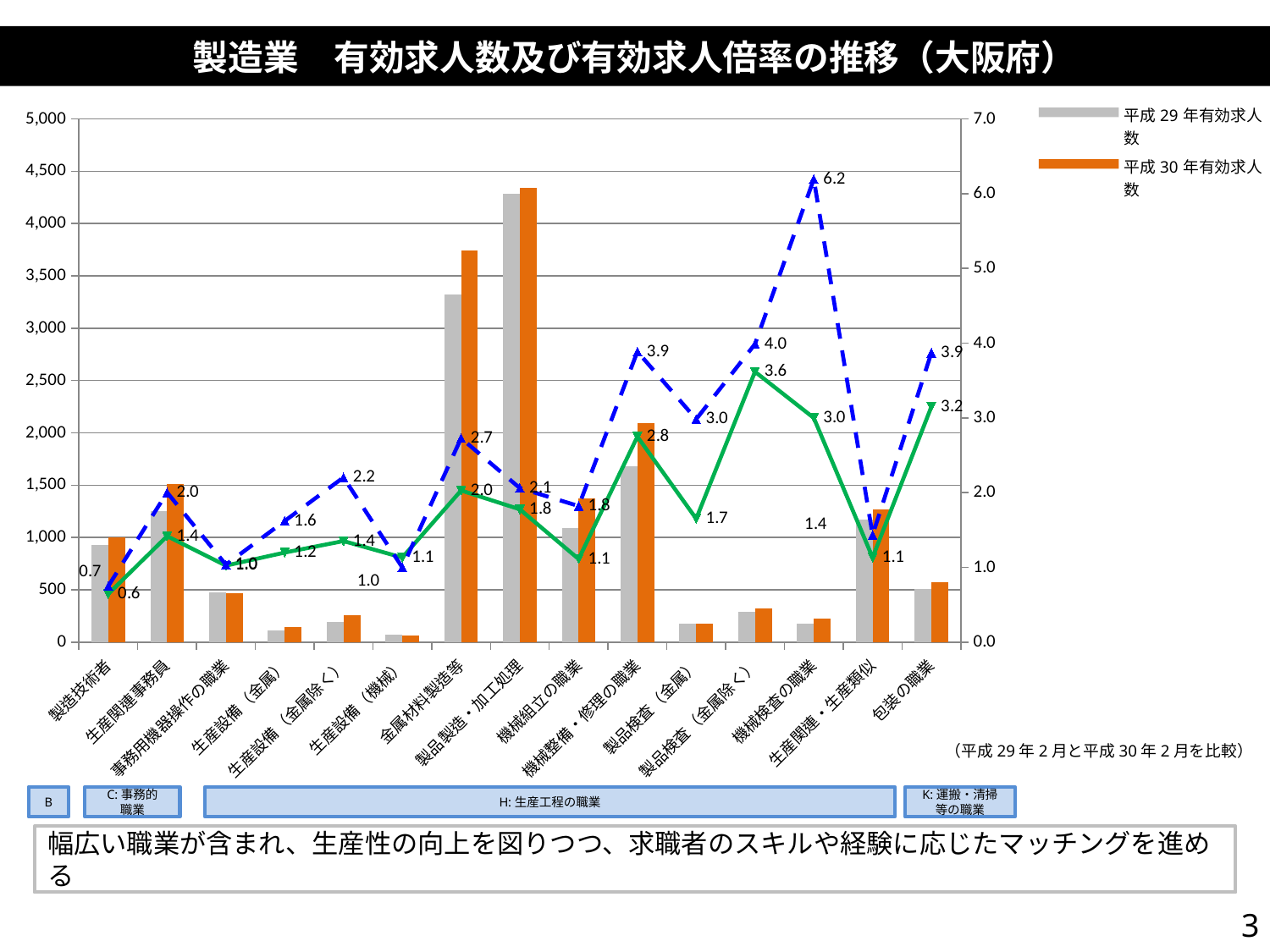
What is the title of the chart? 製造業 有効求人数及び有効求人倍率の推移（大阪府） What kind of chart is this? Combination bar and line chart Which category has the highest bars for both 平成29年有効求人数 and 平成30年有効求人数? 製品製造・加工処理 Is the 平成30年有効求人数 value for 製品製造・加工処理 greater or less than 4,000? greater How many series does the legend list? 2 At 機械整備・修理の職業, which is larger: the blue dashed line value or the green solid line value? The blue dashed line (3.9) How many occupation categories are shown on the x axis? 15 Is the 平成29年有効求人数 value for 金属材料製造等 greater or less than 3,500? less What value does the blue dashed line show for 機械検査の職業? 6.2 What value does the green solid line show for 製品検査（金属除く）? 3.6 Which category has the lowest 平成30年有効求人数 bar? 生産設備（機械） At 機械検査の職業, what is the difference between the blue dashed line value and the green solid line value? 3.2